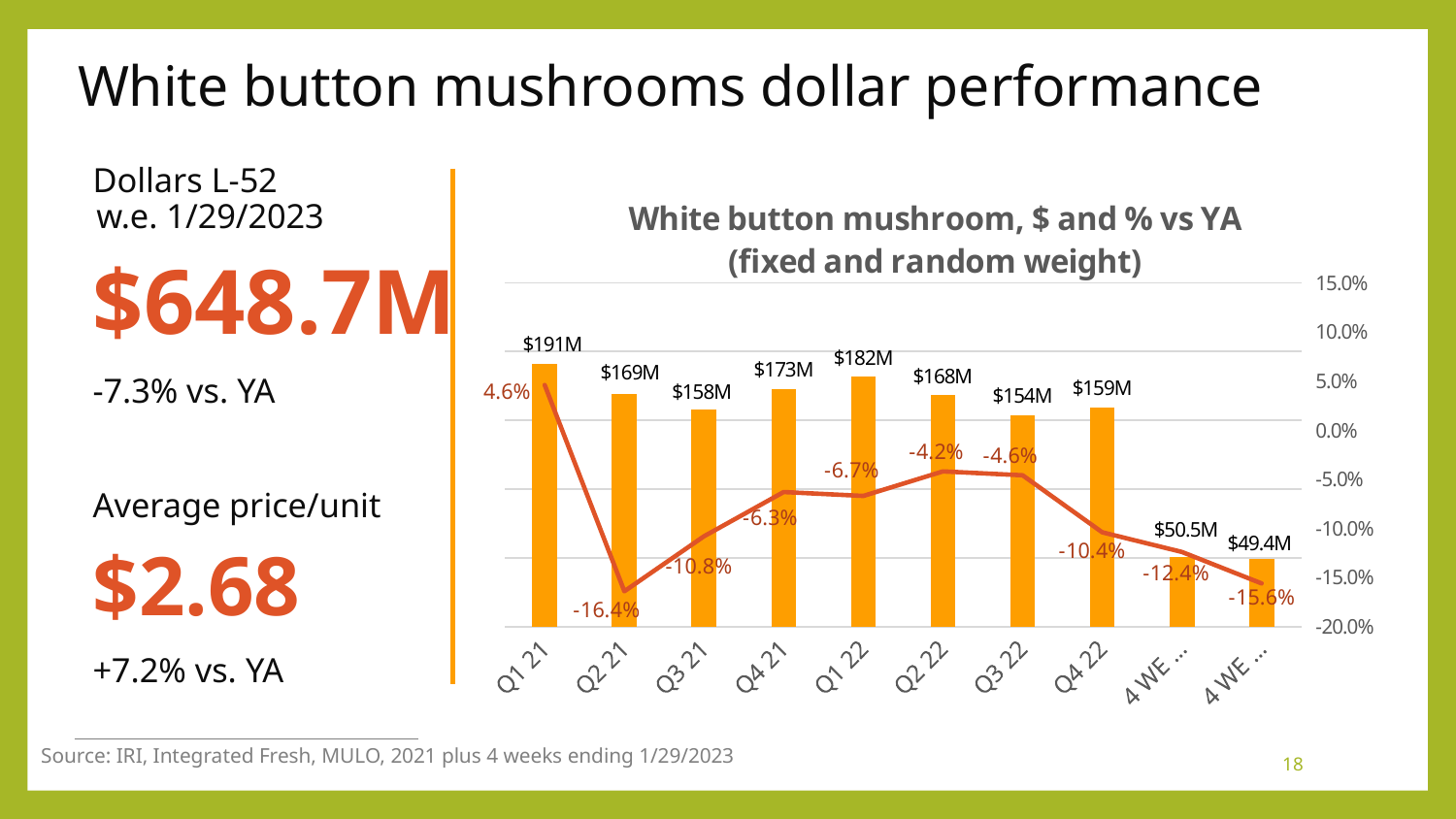
Which has the larger dollar value, Q4 21 or Q3 22? Q4 21 What is the dollar value shown for Q1 21? $191M What is the dollar value shown for Q3 22? $154M What kind of chart is shown on the slide? A bar chart combined with a line chart Which quarter has the lowest % vs YA value on the line? Q2 21 From Q2 21 to Q4 21, does the % vs YA line rise or fall? Rise Which quarter has the highest dollar value bar? Q1 21 What is the % vs YA value shown for Q2 21? -16.4% What is the difference in dollars between Q1 22 and Q2 22? $14M What is the title of the chart? White button mushroom, $ and % vs YA (fixed and random weight) What is the difference in dollars between Q1 21 and Q2 21? $22M What is the % vs YA value shown for Q4 22? -10.4%